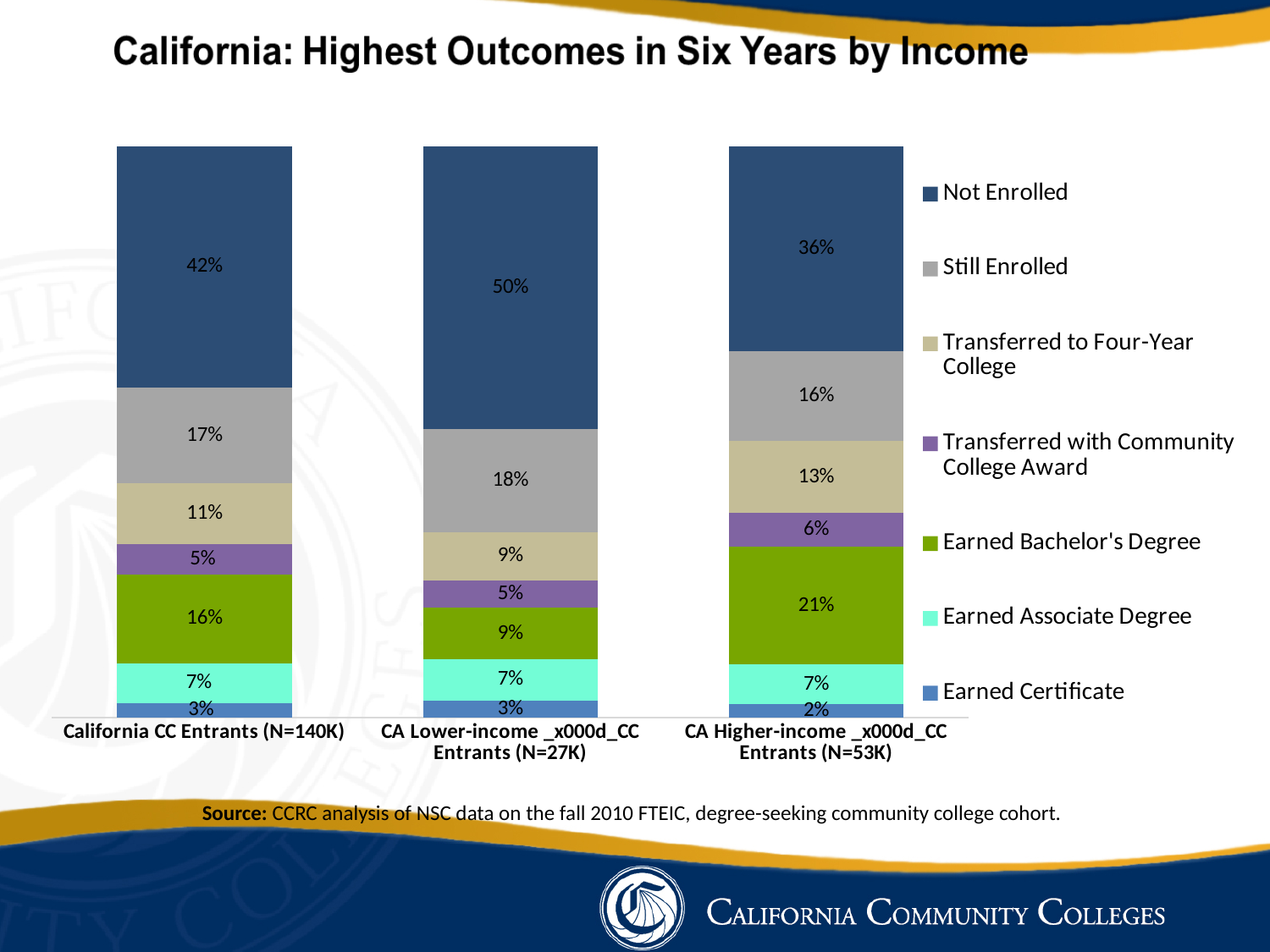
What is the difference in the Earned Bachelor's Degree share between CA Higher-income CC Entrants and CA Lower-income CC Entrants? 12% Which is larger: the Still Enrolled share for California CC Entrants (N=140K) or for CA Lower-income CC Entrants (N=27K)? CA Lower-income CC Entrants (N=27K) What is the Not Enrolled value for CA Lower-income CC Entrants (N=27K)? 50% How many bars (groups of entrants) are plotted in the chart? 3 What type of chart is shown on the slide? Stacked bar chart Which group has the highest Not Enrolled share? CA Lower-income CC Entrants (N=27K) How many series does the legend list? 7 What is the Transferred to Four-Year College value for California CC Entrants (N=140K)? 11% Which group has the lowest Earned Bachelor's Degree share? CA Lower-income CC Entrants (N=27K) What is the Earned Bachelor's Degree value for CA Higher-income CC Entrants (N=53K)? 21% What is the title of the chart? California: Highest Outcomes in Six Years by Income What is the Earned Certificate value for CA Higher-income CC Entrants (N=53K)? 2%